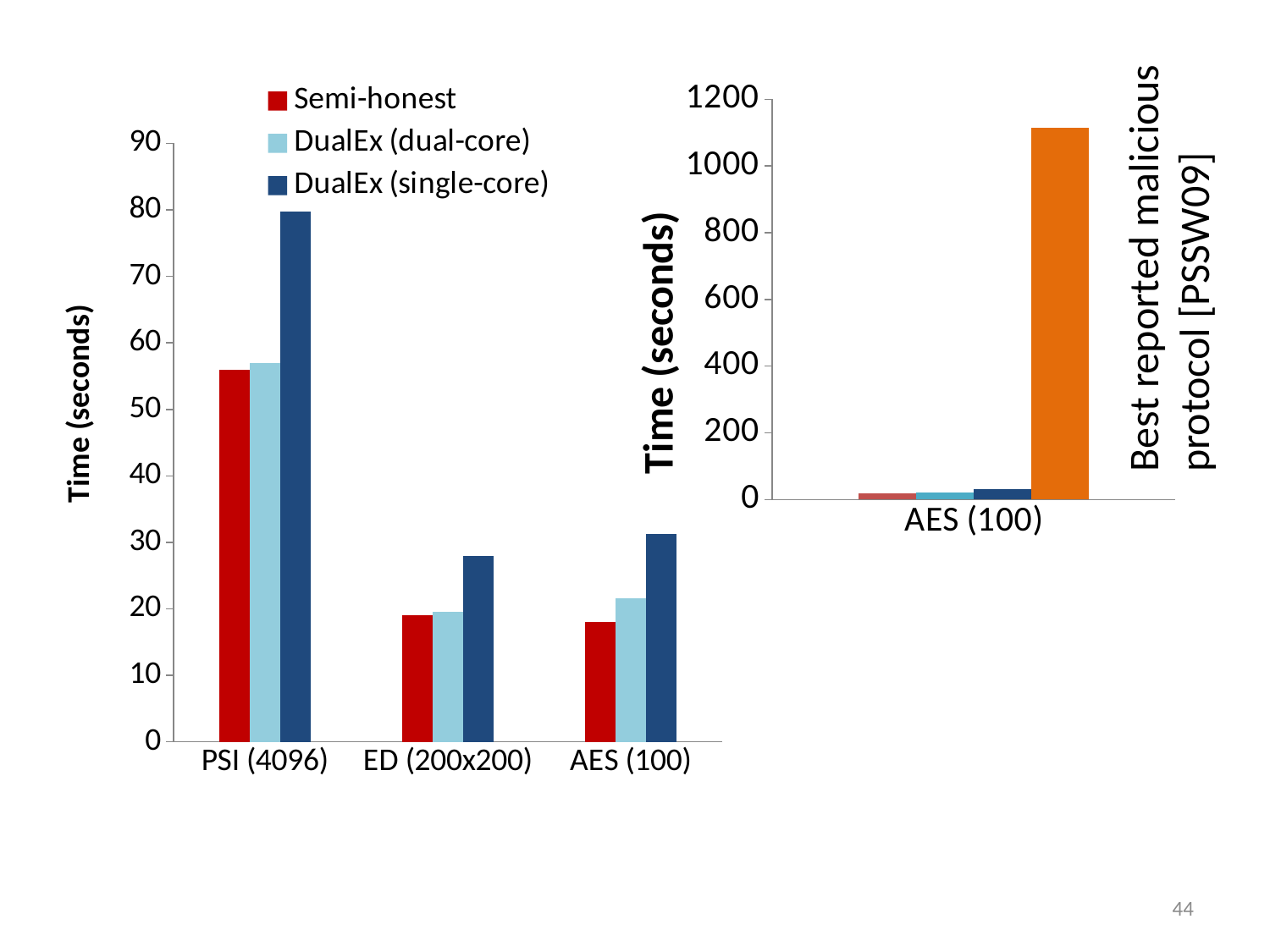
In the left chart, is the DualEx (single-core) value for PSI (4096) greater or less than 70? greater In the right chart, is the value of the orange bar (Best reported malicious protocol [PSSW09]) greater or less than 1000? greater How many series does the legend of the left chart list? 3 What is the y-axis label of the right chart? Time (seconds) How many categories are shown on the x axis of the left chart? 3 What kind of chart is the chart on the left of the slide? bar chart In the left chart, which is larger for AES (100): the Semi-honest value or the DualEx (single-core) value? DualEx (single-core) In the left chart, is the DualEx (single-core) value for ED (200x200) greater or less than 20? greater What is the category label shown on the x axis of the right chart? AES (100) In the left chart, which series has the highest value for ED (200x200)? DualEx (single-core) In the left chart, which category has the highest DualEx (single-core) value? PSI (4096)